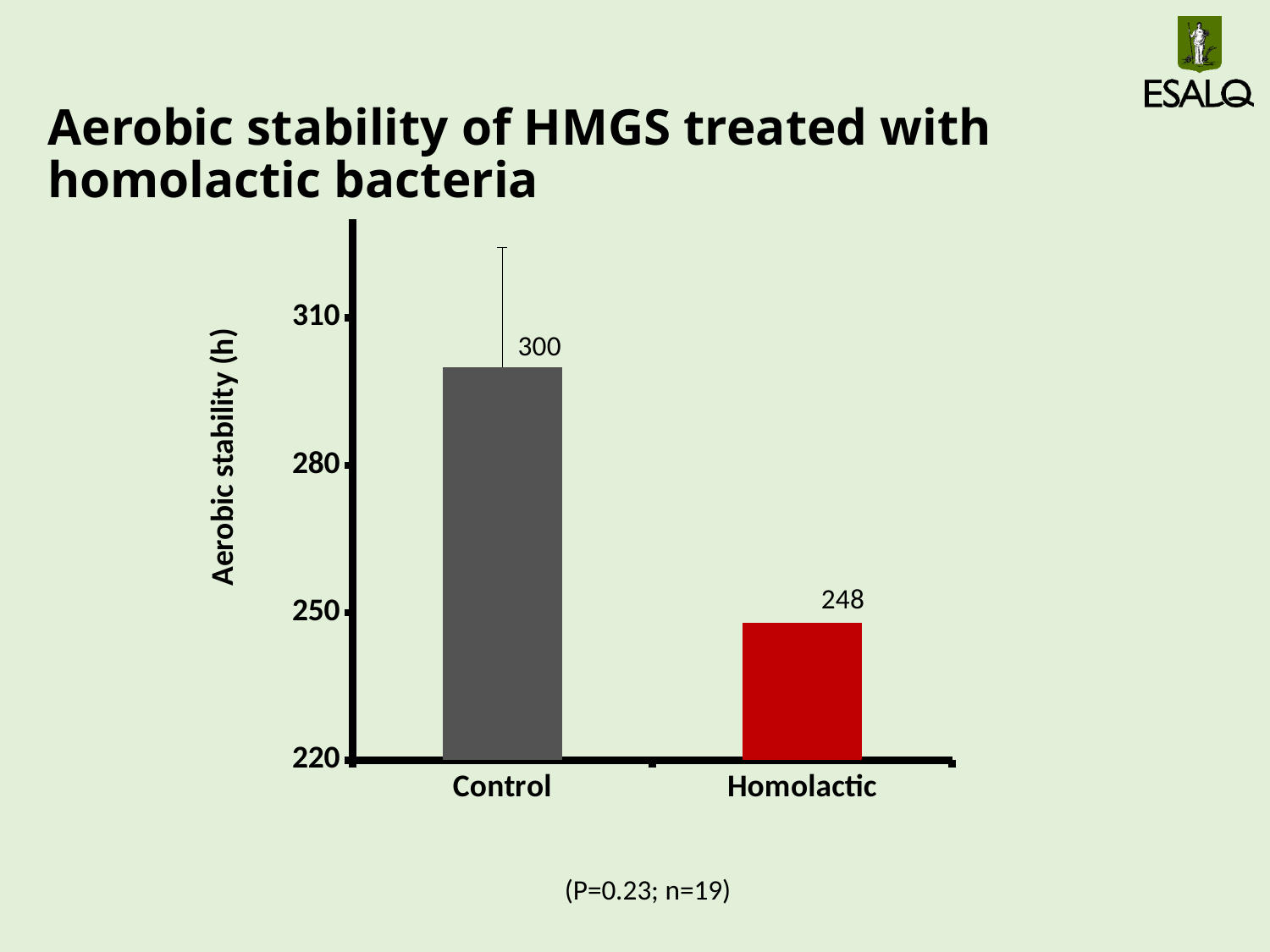
What is the label of the y axis? Aerobic stability (h) Is the value for Control greater or less than 280? greater What is the aerobic stability value for Control? 300 How many categories are shown on the x axis? 2 What is the aerobic stability value for Homolactic? 248 Which category has the highest aerobic stability? Control What kind of chart is shown on the slide? bar chart Which category has the lowest aerobic stability? Homolactic What colour is the Homolactic bar? red Is the value for Homolactic greater or less than 250? less Which has a larger aerobic stability value, Control or Homolactic? Control What is the difference in aerobic stability between Control and Homolactic? 52